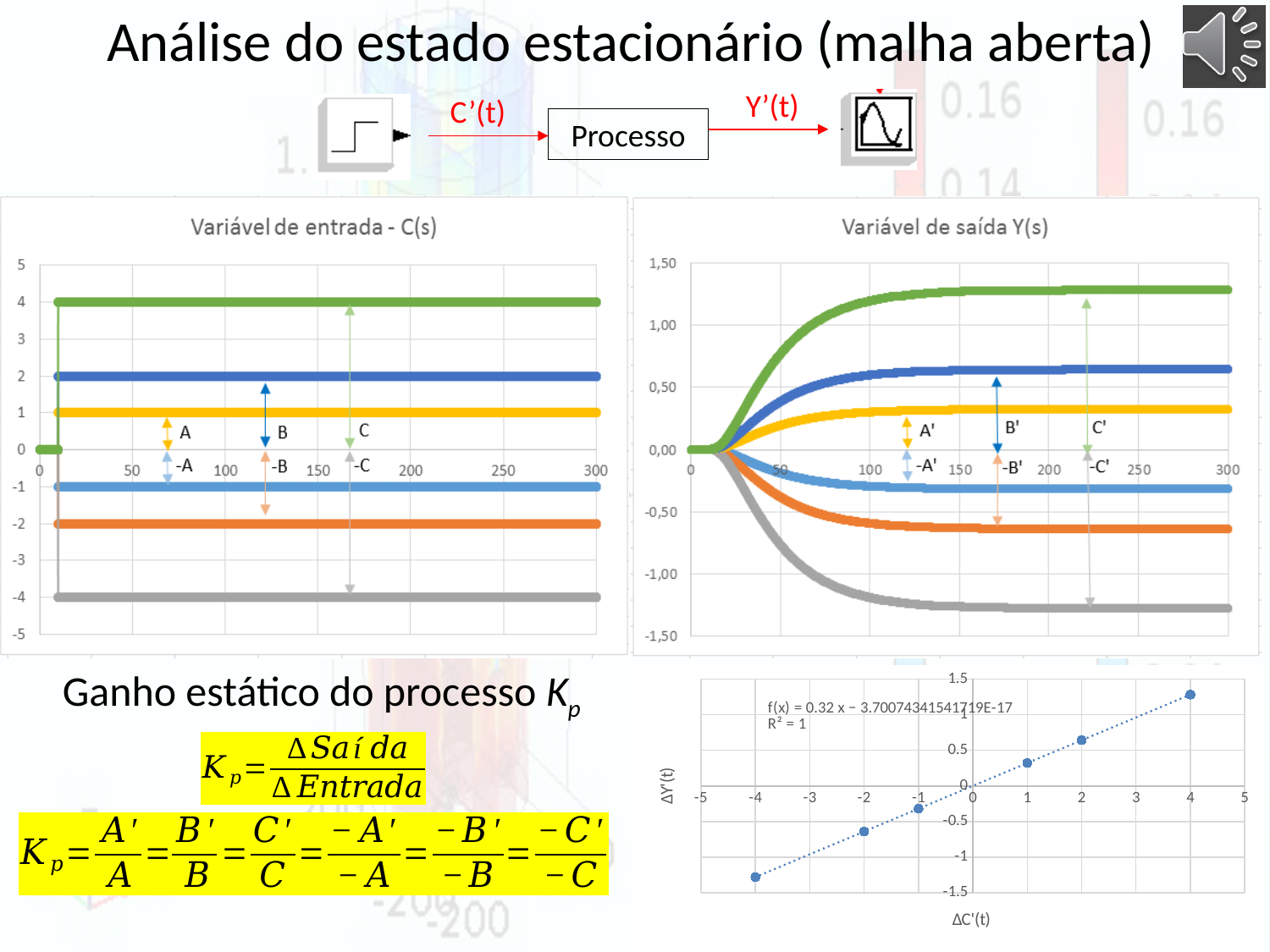
In the chart titled 'Variável de entrada - C(s)', what value does the grey line settle at after the step? -4 In the chart titled 'Variável de entrada - C(s)', which line reaches the highest value? the green line In the chart titled 'Variável de saída Y(s)', is the final value of the green curve greater or less than 1,00? greater In the chart titled 'Variável de saída Y(s)', is the final value of the dark blue curve greater or less than 0,50? greater In the scatter chart at the bottom right, what is the R² value shown? 1 In the chart titled 'Variável de entrada - C(s)', what value does the green line settle at after the step? 4 In the chart titled 'Variável de saída Y(s)', is the final value of the grey curve greater or less than -1,00? less In the scatter chart at the bottom right, what is the slope of the fitted line f(x)? 0.32 In the chart titled 'Variável de entrada - C(s)', how many step lines are plotted? 6 What is the title of the chart on the left? Variável de entrada - C(s) In the chart titled 'Variável de entrada - C(s)', what value does the orange line settle at after the step? -2 In the chart titled 'Variável de saída Y(s)', which curve reaches the lowest value? the grey curve